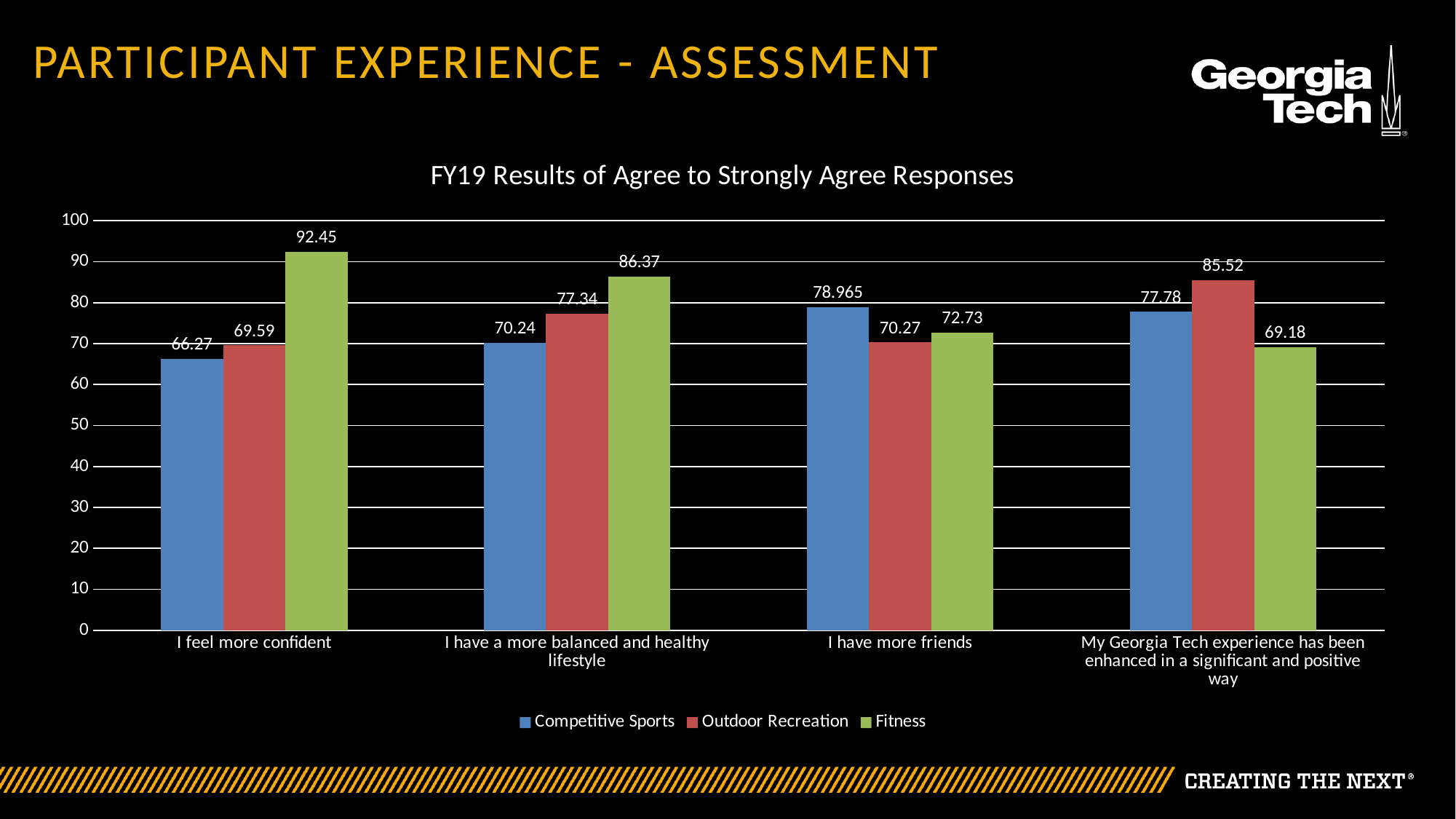
For "I have more friends", which series has the larger value: Competitive Sports or Fitness? Competitive Sports How many series does the legend list? 3 What kind of chart is shown on the slide? bar chart Which category has the lowest Competitive Sports value? I feel more confident What is the Competitive Sports value for "I have more friends"? 78.965 What is the title of the chart? FY19 Results of Agree to Strongly Agree Responses What is the Outdoor Recreation value for "My Georgia Tech experience has been enhanced in a significant and positive way"? 85.52 Which category has the highest Fitness value? I feel more confident What is the difference between the Fitness and Competitive Sports values for "I have a more balanced and healthy lifestyle"? 16.13 What is the Fitness value for "I feel more confident"? 92.45 Is the Outdoor Recreation value for "I feel more confident" greater or less than 80? less How many categories are shown on the x axis? 4